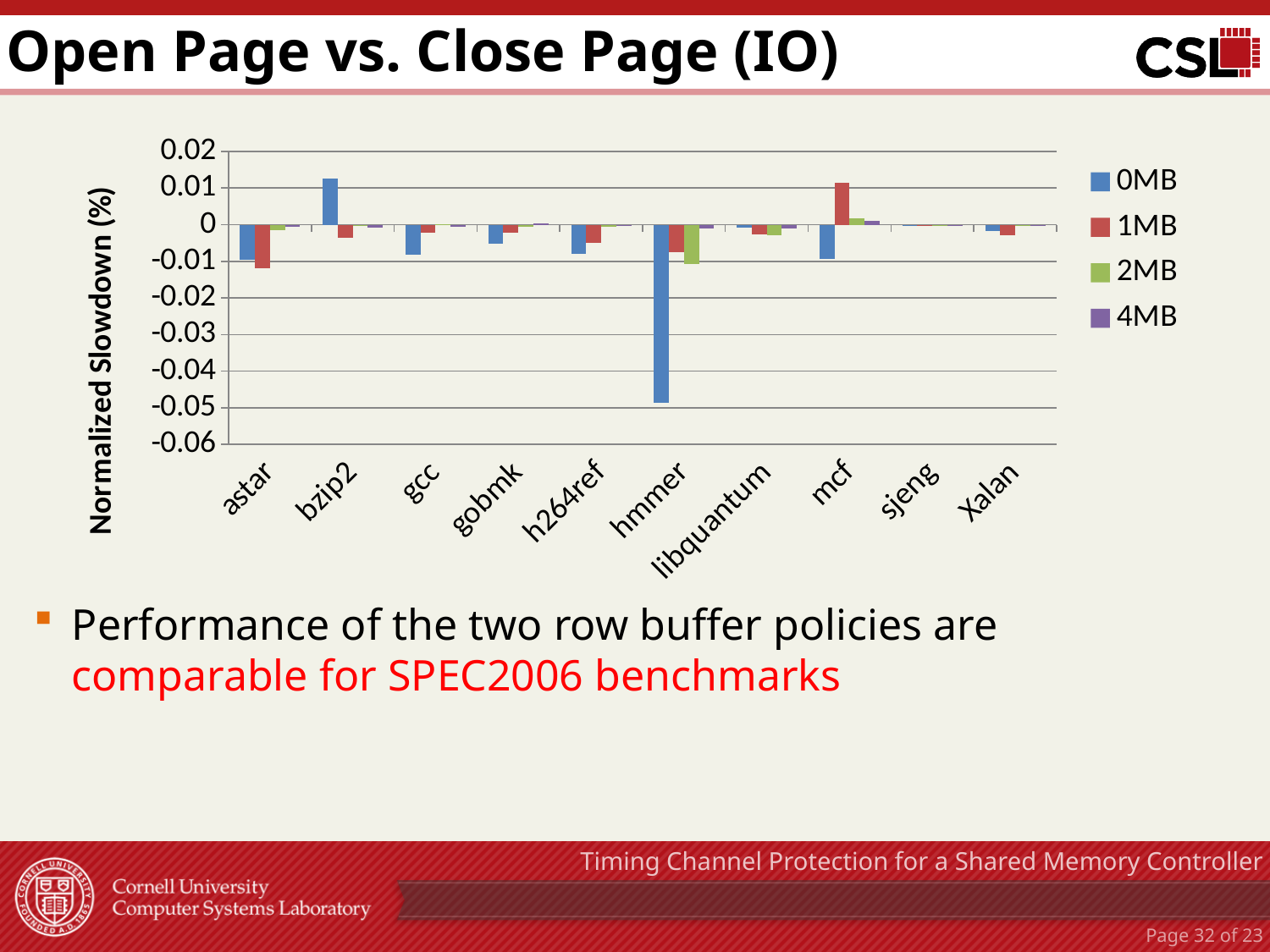
What is the label of the y axis of the chart? Normalized Slowdown (%) Which benchmark has the lowest (most negative) bar in the chart? hmmer Which is lower: the 0MB value for hmmer or the 0MB value for mcf? hmmer Is the 0MB value for hmmer greater or less than -0.04? less For mcf, which is larger: the 0MB value or the 1MB value? 1MB For bzip2, which is larger: the 0MB value or the 1MB value? 0MB Is the 0MB value for mcf greater or less than -0.02? greater What kind of chart is shown on the slide? bar chart For hmmer, which series has the lowest bar? 0MB How many series does the chart legend list? 4 What are the legend entries of the chart? 0MB, 1MB, 2MB, 4MB How many benchmark categories are shown on the x axis of the chart? 10